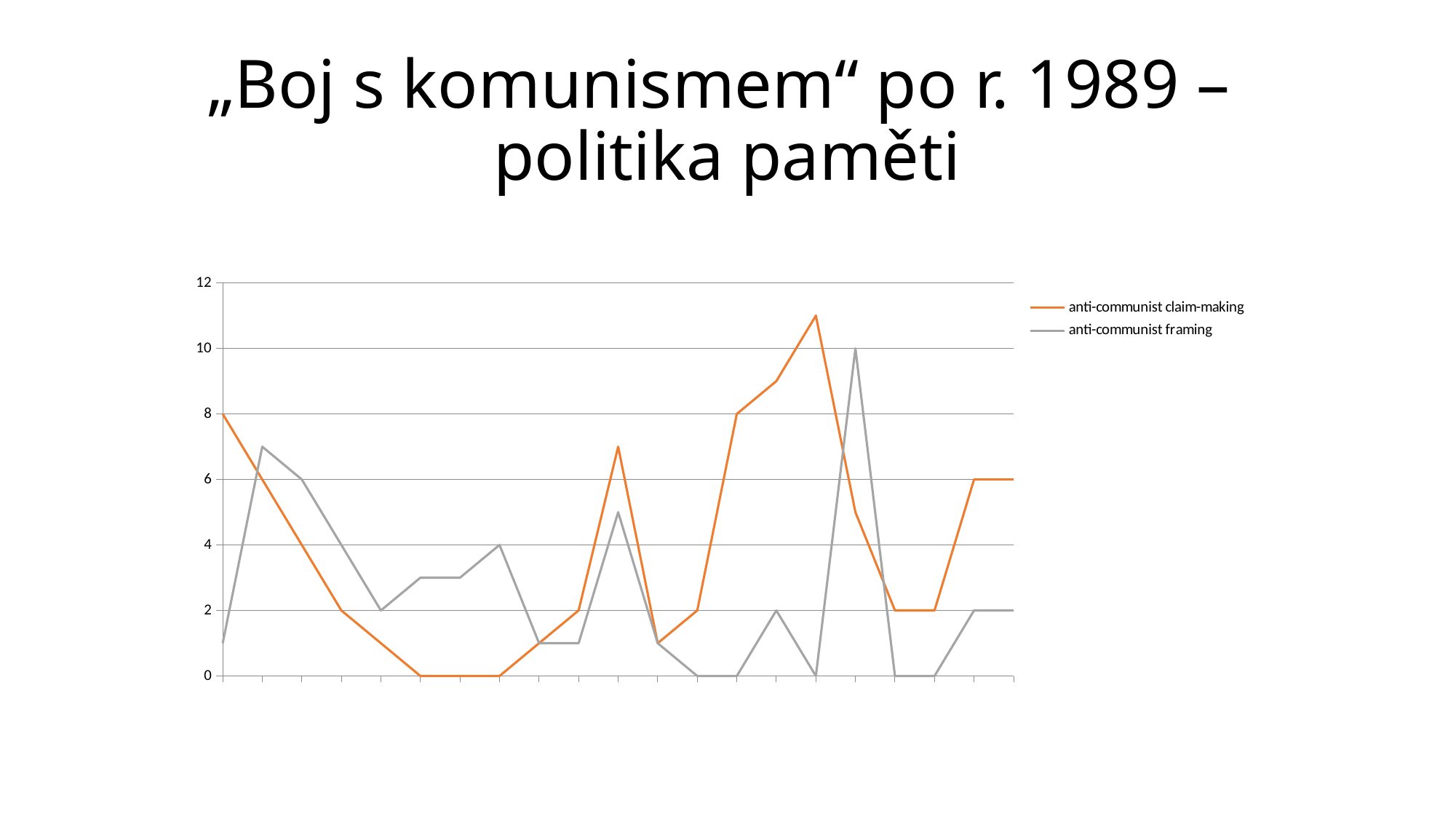
At the first point on the x axis, which series has the higher value? anti-communist claim-making What kind of chart is shown on the slide? line chart What is the value of the last point of the anti-communist framing series? 2 What are the two series named in the legend? anti-communist claim-making and anti-communist framing What is the value of the last point of the anti-communist claim-making series? 6 What is the difference between the last points of the anti-communist claim-making and anti-communist framing series? 4 What is the value of the first point of the anti-communist claim-making series? 8 How many series does the chart legend list? 2 Which colour is used for the anti-communist claim-making line? orange Is the first point of the anti-communist framing series greater or less than 2? less Is the highest value reached by the anti-communist framing series greater or less than 8? greater Is the highest value reached by the anti-communist claim-making series greater or less than 10? greater